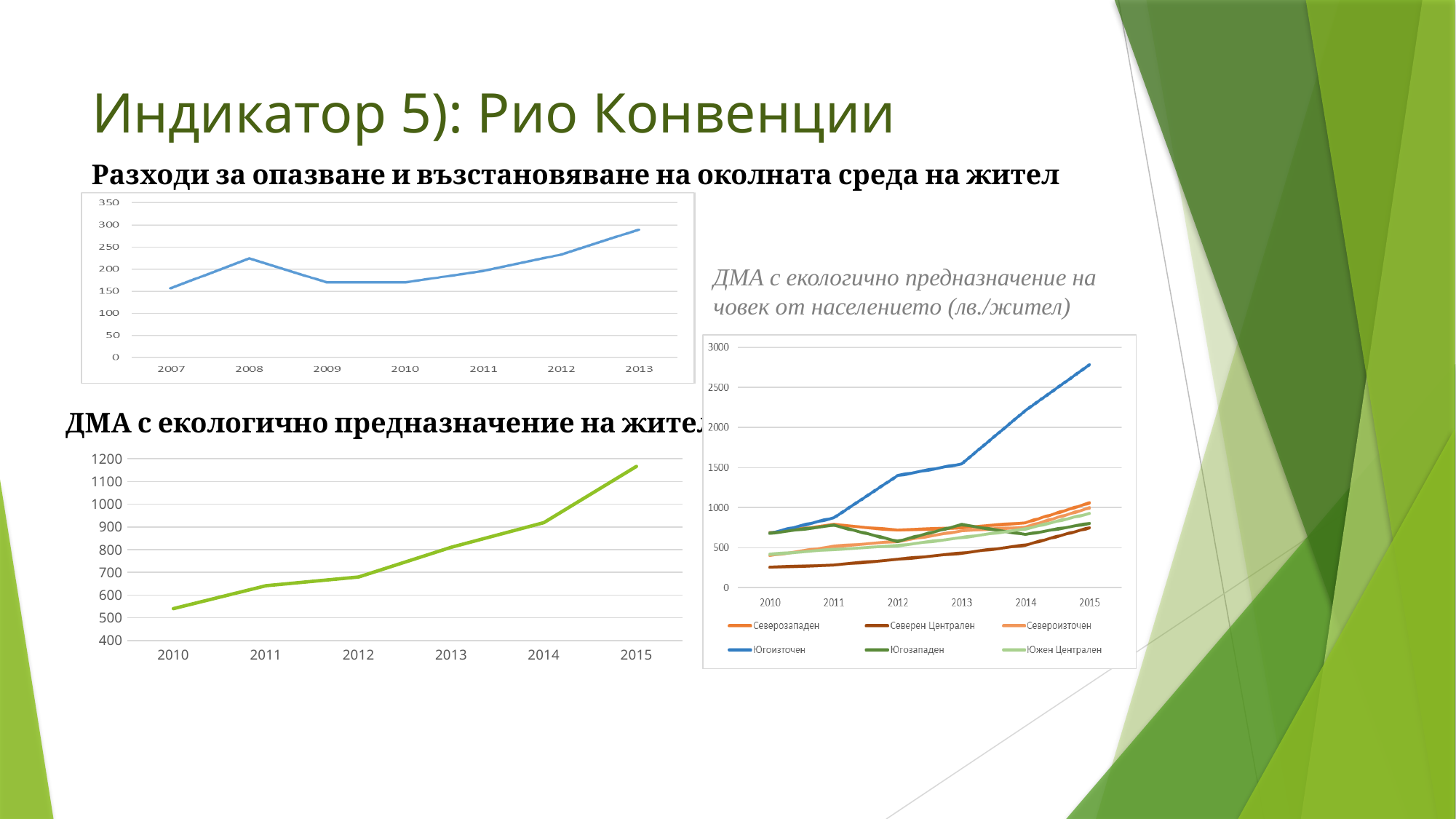
In the bottom-left chart 'ДМА с екологично предназначение на жител', do the values rise or fall from 2010 to 2015? rise What kind of chart is the top-left chart titled 'Разходи за опазване и възстановяване на околната среда на жител'? line chart In the right-hand chart 'ДМА с екологично предназначение на човек от населението (лв./жител)', is the value for Югоизточен in 2015 greater or less than 2500? greater In the top-left chart 'Разходи за опазване и възстановяване на околната среда на жител', is the value for 2013 greater or less than 250? greater In the right-hand chart 'ДМА с екологично предназначение на човек от населението (лв./жител)', which series has the lowest value in 2010? Северен Централен In the top-left chart 'Разходи за опазване и възстановяване на околната среда на жител', is the value for 2009 greater or less than 200? less In the bottom-left chart 'ДМА с екологично предназначение на жител', which year has the lowest value? 2010 In the top-left chart 'Разходи за опазване и възстановяване на околната среда на жител', how many years are shown on the x axis? 7 How many series does the legend of the right-hand chart 'ДМА с екологично предназначение на човек от населението (лв./жител)' list? 6 In the right-hand chart 'ДМА с екологично предназначение на човек от населението (лв./жител)', which series has the highest value in 2015? Югоизточен In the top-left chart 'Разходи за опазване и възстановяване на околната среда на жител', which year has the highest value? 2013